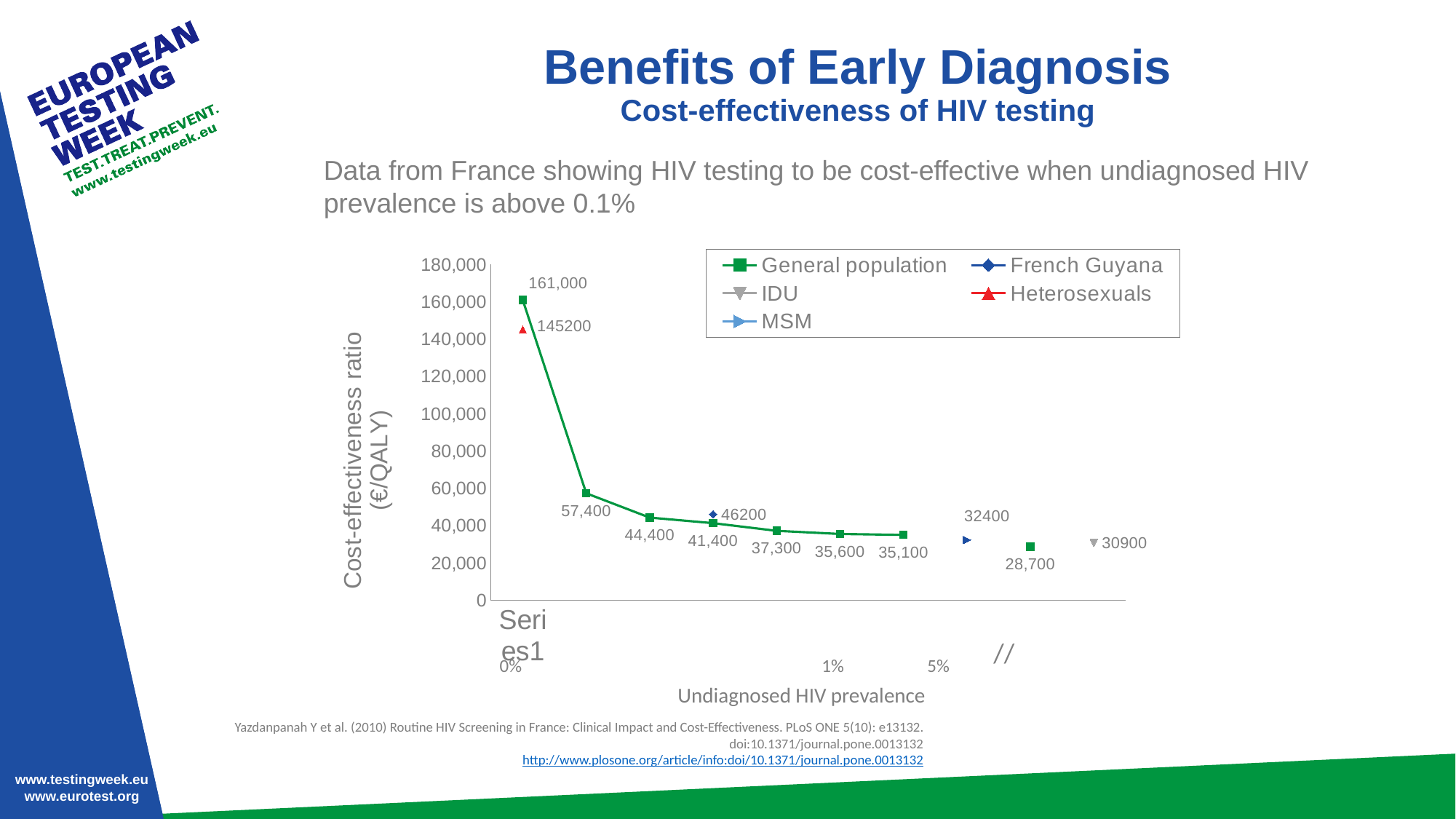
How many labelled data points does the General population series have? 8 What is the difference between the first two labelled General population values, 161,000 and 57,400? 103,600 What is the labelled value for the IDU data point? 30900 What is the labelled value for the Heterosexuals data point? 145200 What is the labelled value for the MSM data point? 32400 What is the highest labelled value for the General population series? 161,000 What is the labelled value for the French Guyana data point? 46200 What is the title of the vertical axis? Cost-effectiveness ratio (€/QALY) Which is larger, the MSM value or the IDU value? MSM Does the General population series rise or fall as undiagnosed HIV prevalence increases along the x axis? Fall What is the lowest labelled value for the General population series? 28,700 How many series does the legend list? 5